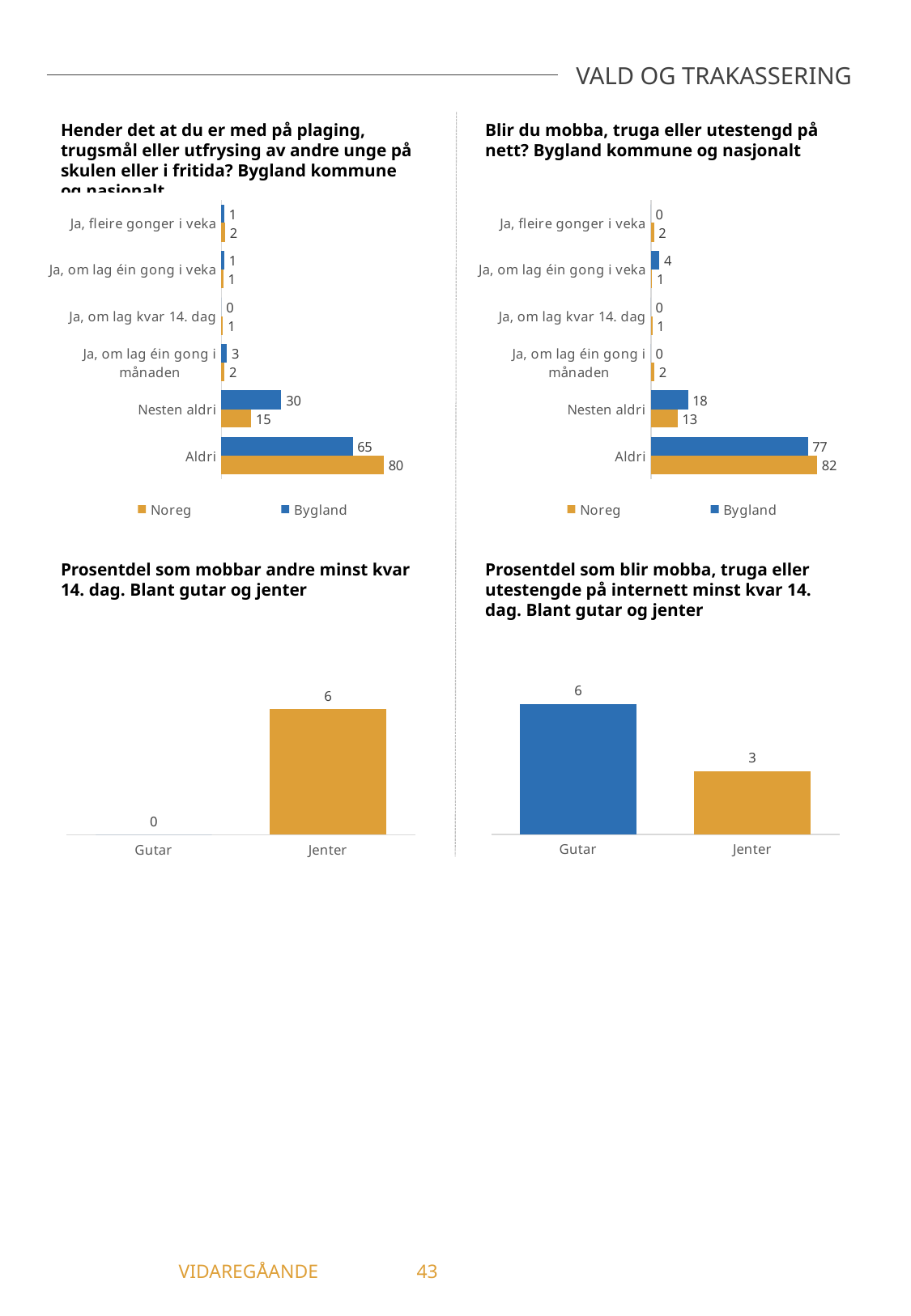
How many categories are shown in the top-left chart ("Hender det at du er med på plaging...")? 6 How many series does the legend list in the top-right chart ("Blir du mobba, truga eller utestengd på nett?")? 2 In the bottom-left chart ("Prosentdel som mobbar andre minst kvar 14. dag"), what is the value for Jenter? 6 What kind of chart is the bottom-right chart ("Prosentdel som blir mobba, truga eller utestengde på internett...")? Bar chart In the top-right chart ("Blir du mobba, truga eller utestengd på nett?"), what is the Noreg value for "Nesten aldri"? 13 In the top-right chart ("Blir du mobba, truga eller utestengd på nett?"), which is larger for "Aldri": Noreg or Bygland? Noreg In the top-left chart ("Hender det at du er med på plaging..."), which category has the highest Bygland value? Aldri In the top-left chart ("Hender det at du er med på plaging..."), what is the difference between the Noreg and Bygland values for "Aldri"? 15 In the bottom-right chart ("Prosentdel som blir mobba, truga eller utestengde på internett..."), what is the difference between Gutar and Jenter? 3 In the top-left chart ("Hender det at du er med på plaging..."), what is the Noreg value for "Aldri"? 80 In the top-right chart ("Blir du mobba, truga eller utestengd på nett?"), what is the Bygland value for "Ja, om lag éin gong i veka"? 4 In the top-left chart ("Hender det at du er med på plaging..."), what is the Bygland value for "Nesten aldri"? 30